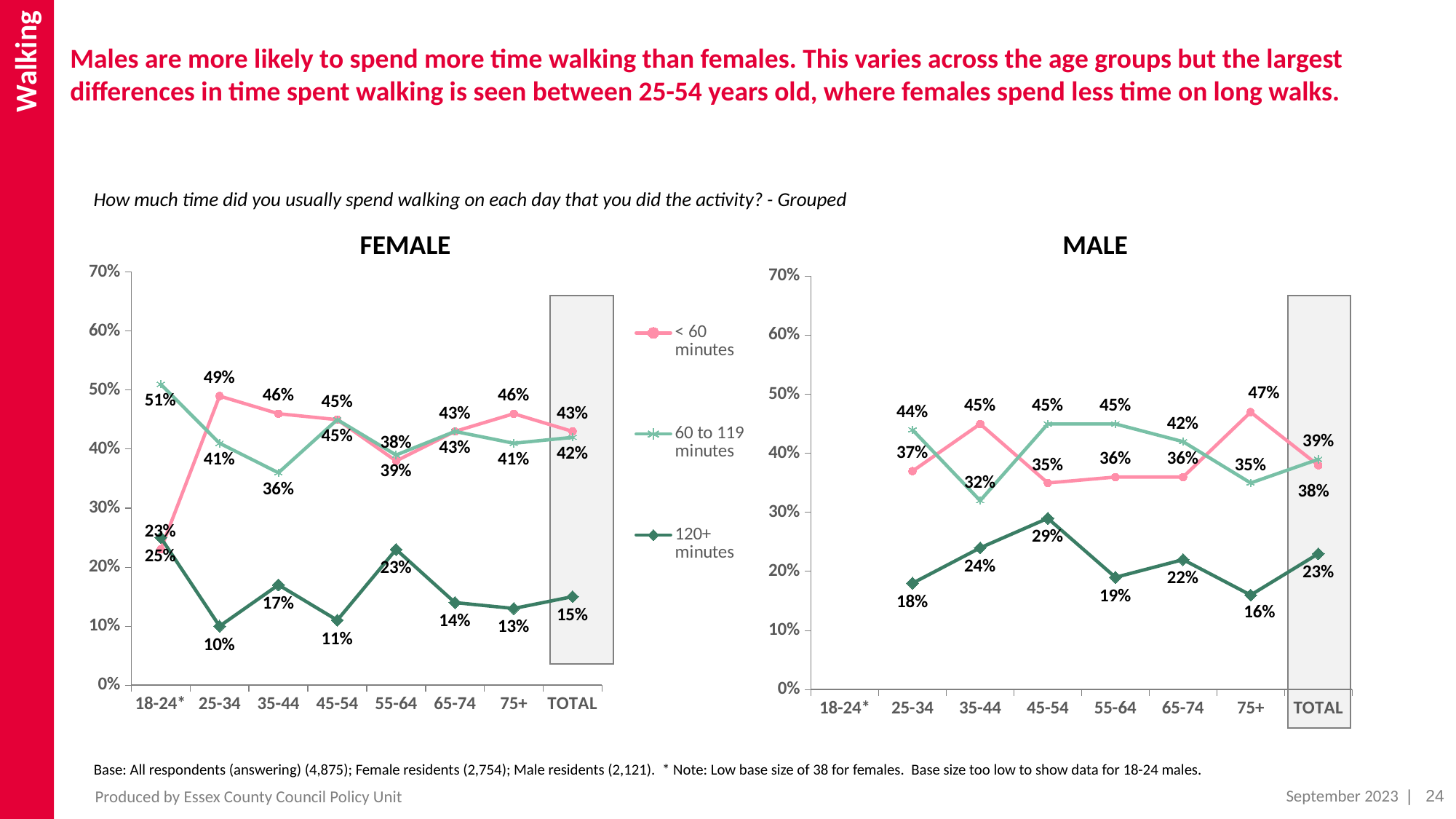
On the MALE chart, does the 120+ minutes series rise or fall from 25-34 to 45-54? rise How many series does the legend list? 3 Which is larger for the TOTAL category: the 120+ minutes value on the FEMALE chart or on the MALE chart? MALE On the MALE chart, which age group has the highest value for the < 60 minutes series? 75+ On the MALE chart, what percentage of males aged 45-54 walk for 120+ minutes? 29% On the MALE chart, what is the difference between the 60 to 119 minutes value and the < 60 minutes value for the 45-54 age group? 10% On the FEMALE chart, which age group has the lowest value for the 120+ minutes series? 25-34 On the FEMALE chart, which age group has the highest value for the 120+ minutes series? 18-24* On the MALE chart, is the 120+ minutes value for the 25-34 age group greater or less than 20%? less On the MALE chart, what is the TOTAL value for the 60 to 119 minutes series? 39% What type of chart is the FEMALE chart? line chart On the FEMALE chart, what percentage of females aged 25-34 walk for less than 60 minutes? 49%